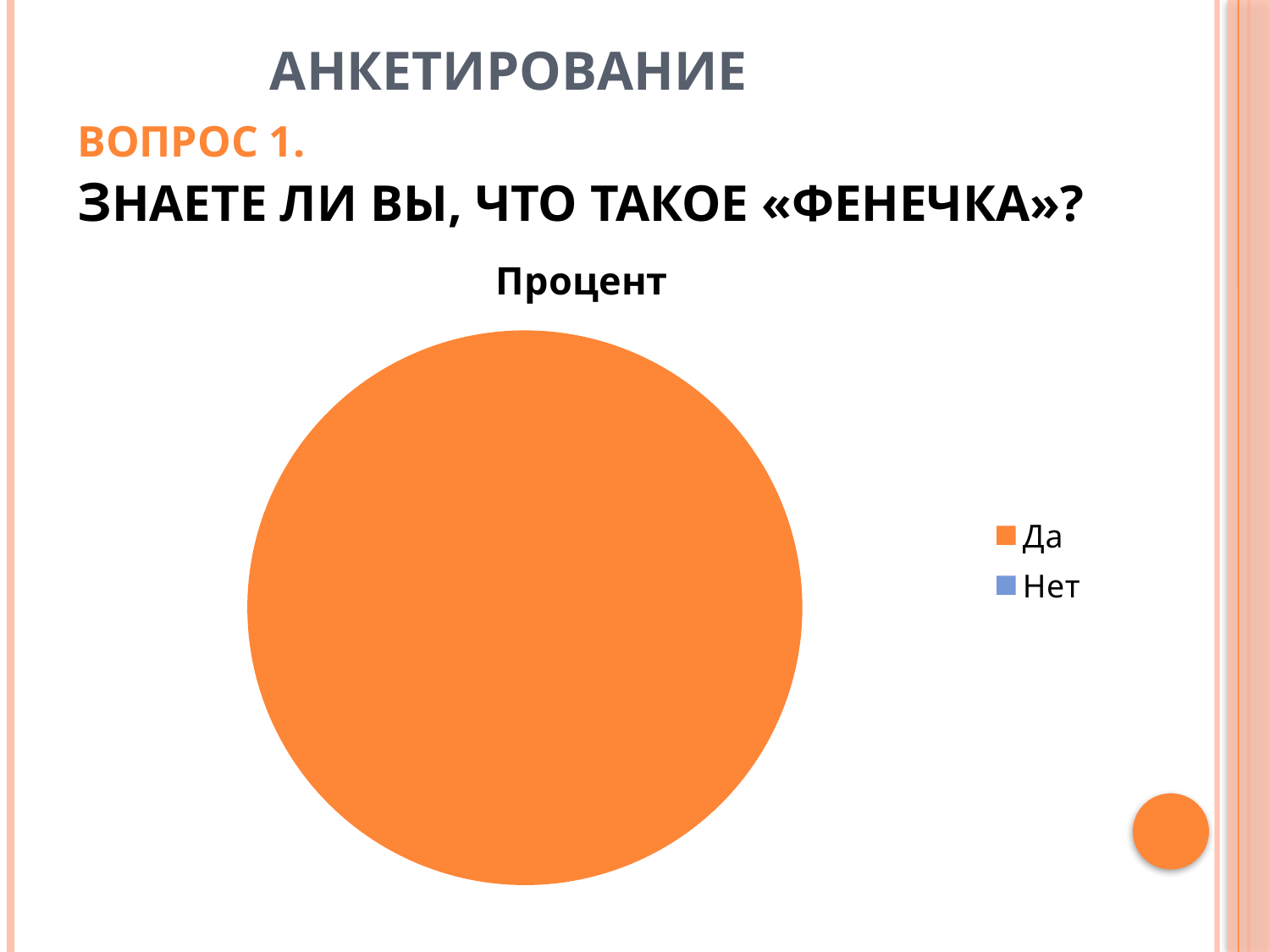
How many entries does the chart legend list? 2 What kind of chart is shown on the slide? pie chart Which category takes up the smallest share of the pie? Нет Which category has the larger share, Да or Нет? Да Is the share for Нет greater or less than 50%? less Which category takes up the largest share of the pie? Да What colour represents the category Да in the chart? orange What is the title of the chart? Процент Is the share for Да greater or less than 50%? greater